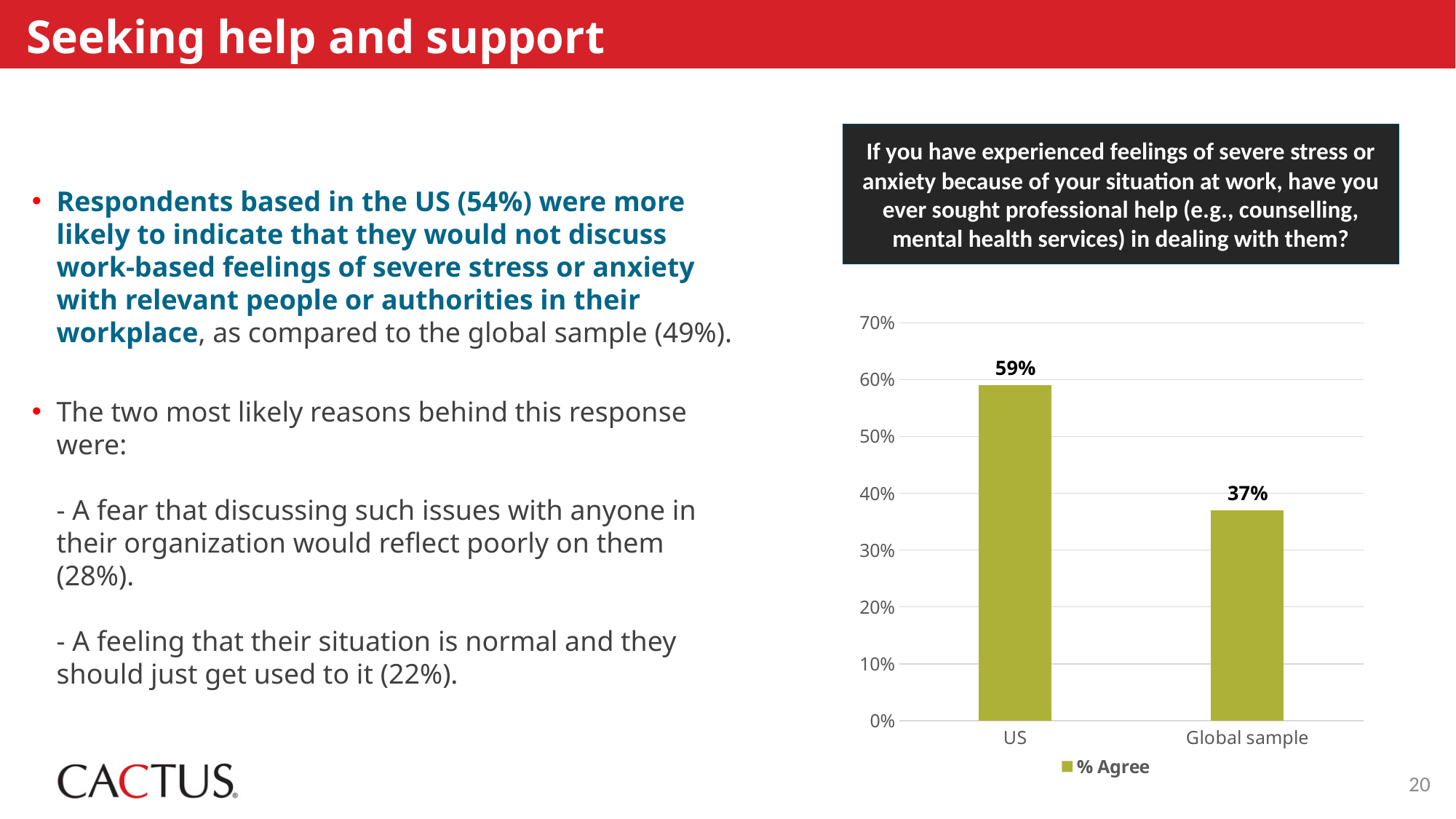
Which category has the lowest value in the chart? Global sample Is the value for US greater or less than 50%? greater What is the value for Global sample in the chart? 37% What is the value for US in the chart? 59% Which category has the highest value in the chart? US Which is larger, the value for US or the value for Global sample? US What is the difference between the US value and the Global sample value? 22% What kind of chart is shown on the slide? Bar chart Is the value for Global sample greater or less than 40%? less How many series does the chart legend list? 1 How many categories are shown in the chart? 2 What is the name of the series shown in the chart legend? % Agree